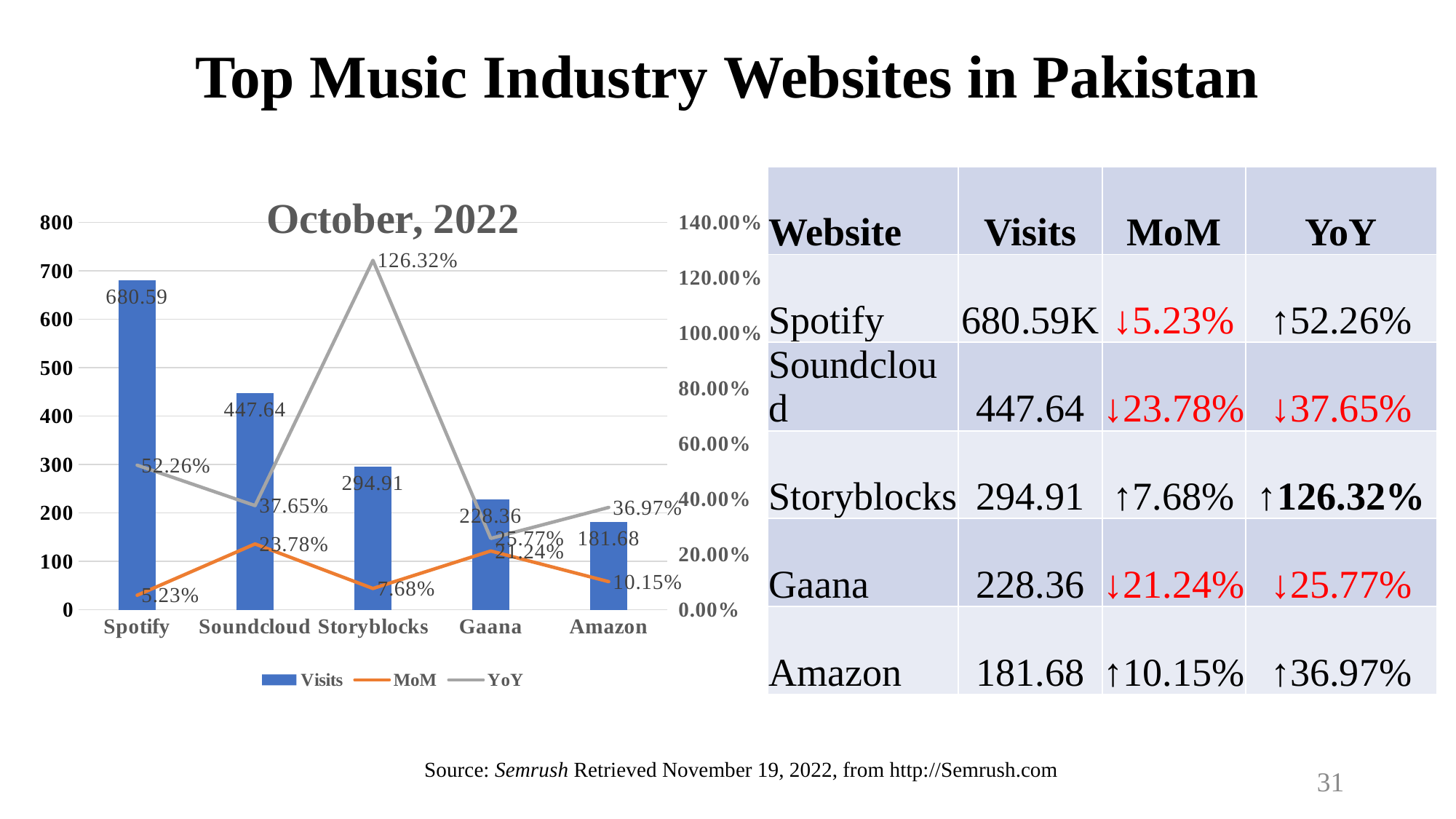
What is the difference in Visits between Spotify and Soundcloud? 232.95 Which website has the highest YoY value? Storyblocks Which website has the highest Visits value? Spotify What is the Visits value for Spotify? 680.59 How many series does the chart legend list? 3 Which website has the lowest Visits value? Amazon What is the YoY value for Storyblocks? 126.32% What is the title of the chart? October, 2022 How many websites are shown on the x axis of the chart? 5 Do the Visits values rise or fall from Spotify to Amazon along the x axis? fall Which is larger, the MoM value for Soundcloud or the MoM value for Amazon? Soundcloud What is the MoM value for Gaana? 21.24%